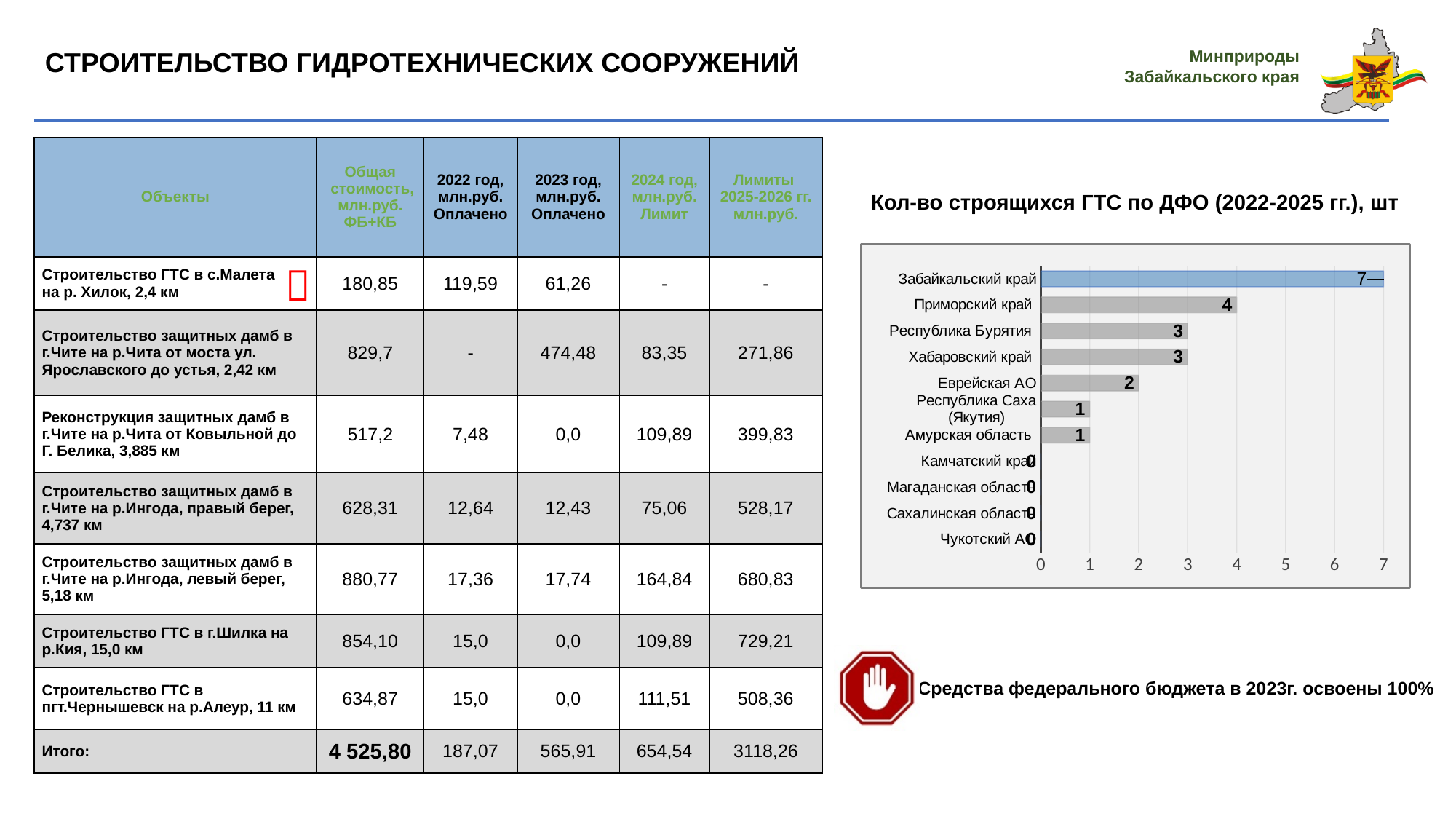
How many regions are listed on the chart? 11 What is the value for Забайкальский край? 7 What is the difference between the values for Забайкальский край and Приморский край? 3 What is the value for Амурская область? 1 What kind of chart is shown on the slide? bar chart Which bar is coloured differently (blue) from the others? Забайкальский край Which is larger, the value for Хабаровский край or the value for Еврейская АО? Хабаровский край How many regions have a value of 0? 4 What is the title of the chart? Кол-во строящихся ГТС по ДФО (2022-2025 гг.), шт What is the value for Приморский край? 4 What is the value for Еврейская АО? 2 Which region has the highest value? Забайкальский край